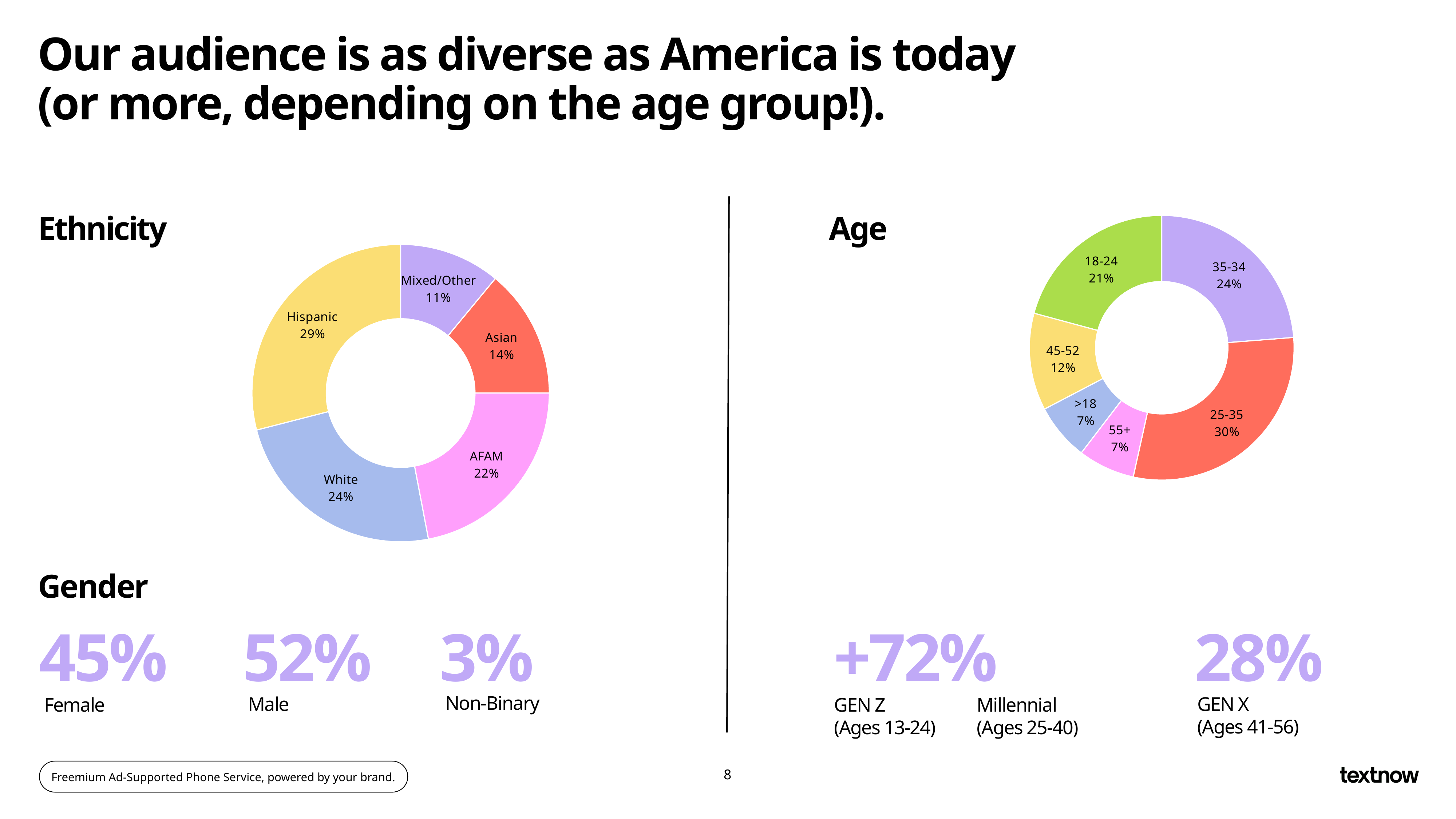
In the Ethnicity chart, what percentage is Hispanic? 29% In the Ethnicity chart, what percentage is AFAM? 22% In the Age chart, how many age groups are shown? 6 In the Age chart, what percentage is the 18-24 group? 21% In the Age chart, what percentage is the 25-35 group? 30% What kind of chart is the Ethnicity chart? Doughnut chart In the Ethnicity chart, what is the difference between the Hispanic and White shares? 5% In the Ethnicity chart, which category has the smallest share? Mixed/Other In the Ethnicity chart, how many categories are shown? 5 In the Age chart, which is larger, the 35-34 group or the 45-52 group? 35-34 In the Age chart, which age group has the largest share? 25-35 In the Ethnicity chart, which category has the largest share? Hispanic